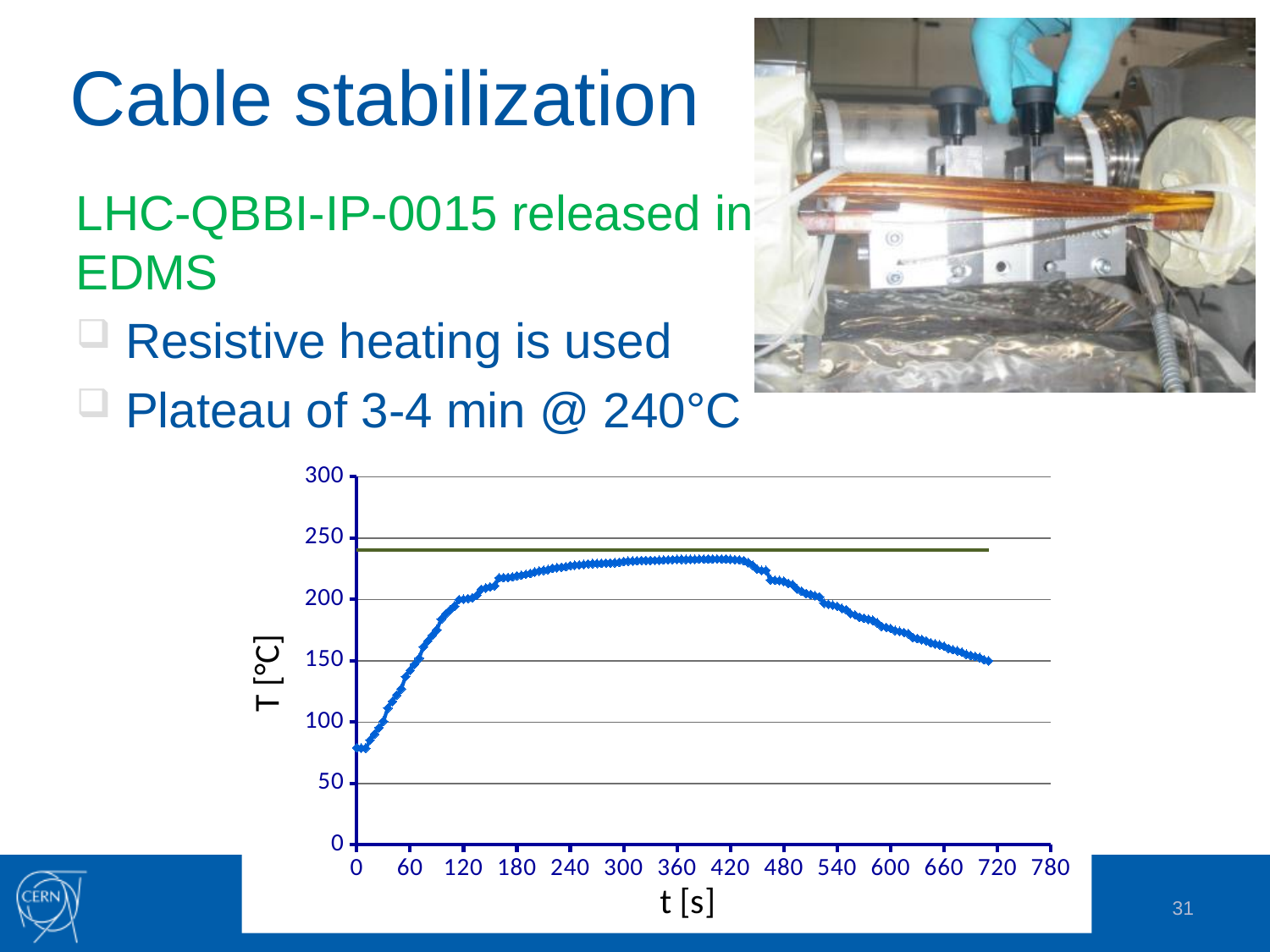
What is the label of the vertical axis of the chart? T [°C] Is the highest temperature reached by the blue curve greater or less than 250? less Is the temperature at t = 600 s greater or less than 150? greater Does the temperature rise or fall between t = 0 s and t = 300 s? rise What kind of chart is shown on the slide? line chart Is the temperature at t = 300 s greater or less than 200? greater Does the temperature rise or fall between t = 420 s and t = 720 s? fall What is the label of the horizontal axis of the chart? t [s] Which is higher at t = 540 s: the blue temperature curve or the green horizontal line? the green horizontal line